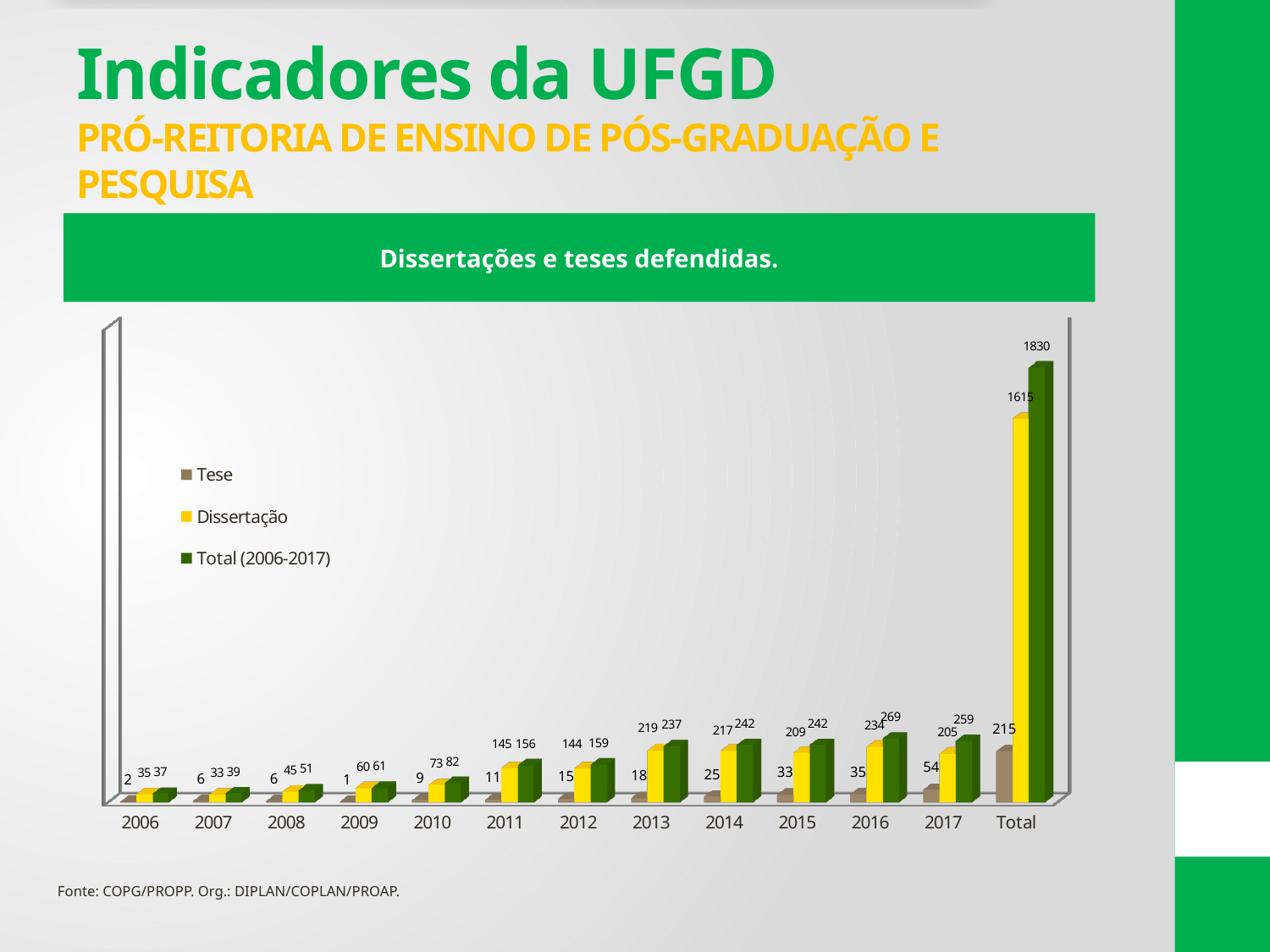
What is the value for Dissertação in the Total category? 1615 How many categories are shown on the x axis? 13 What is the title of the chart? Dissertações e teses defendidas. What kind of chart is shown on the slide? Bar chart Among the years 2006 to 2017, which year has the highest value for Tese? 2017 What is the value for Tese in 2017? 54 Among the years 2006 to 2017, which year has the lowest value for Dissertação? 2007 What is the value for Dissertação in 2013? 219 How many series does the legend list? 3 What is the value of the Total (2006-2017) series for 2016? 269 Which is larger, the Total (2006-2017) value for 2013 or for 2014? 2014 What is the difference between the Dissertação values for 2016 and 2017? 29